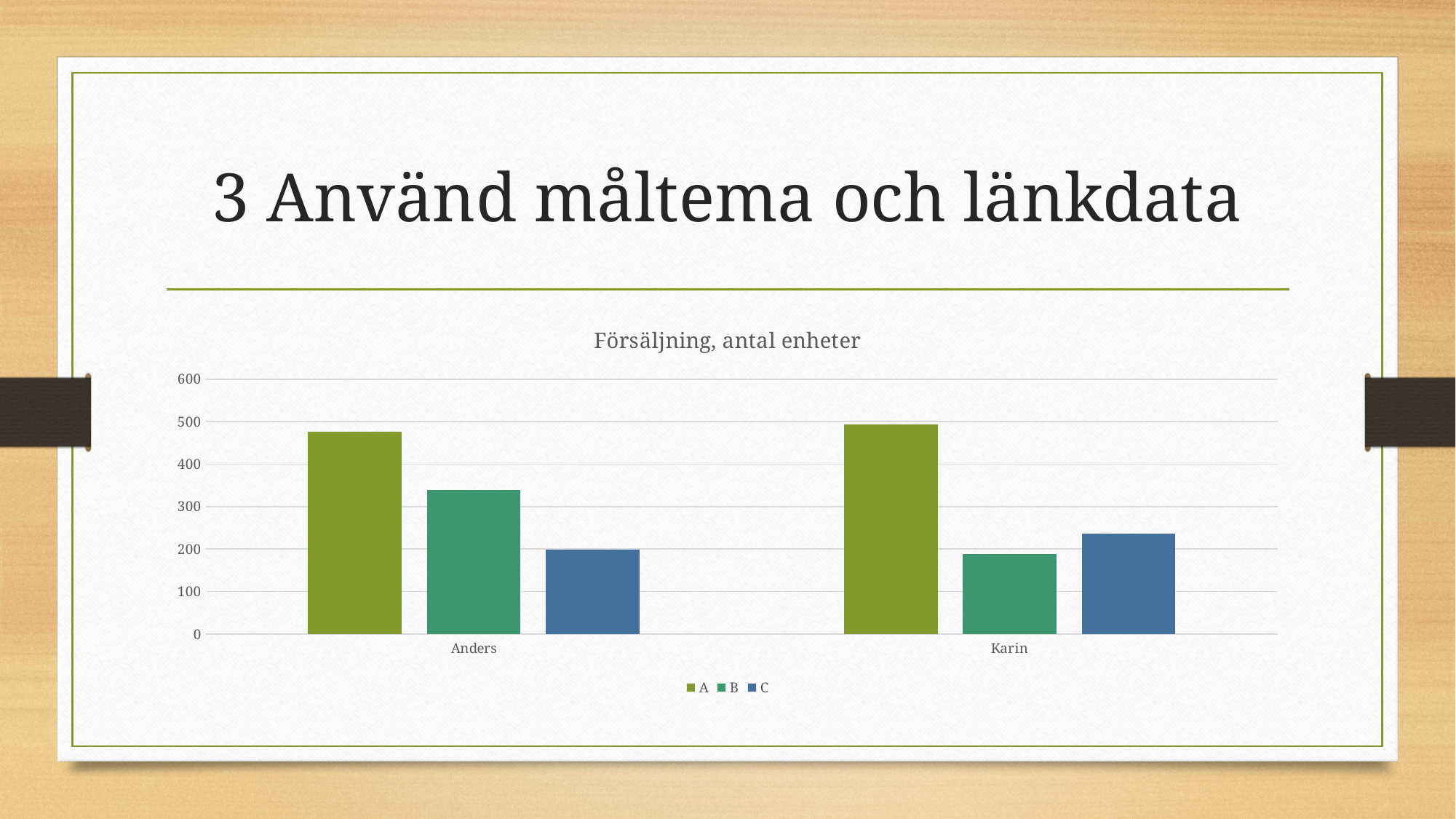
Is the value of series C for Karin greater or less than 300? less Which series has the lowest value for Karin? B What type of chart is shown on the slide? bar chart Is the value of series B for Anders greater or less than 300? greater How many categories are shown on the x axis? 2 How many series does the legend list? 3 Is the value of series A for Anders greater or less than 400? greater What is the title of the chart? Försäljning, antal enheter Which is larger, the value of series C for Anders or for Karin? Karin Which series has the lowest value for Anders? C Which series has the highest value for Anders? A Which is larger, the value of series B for Anders or for Karin? Anders